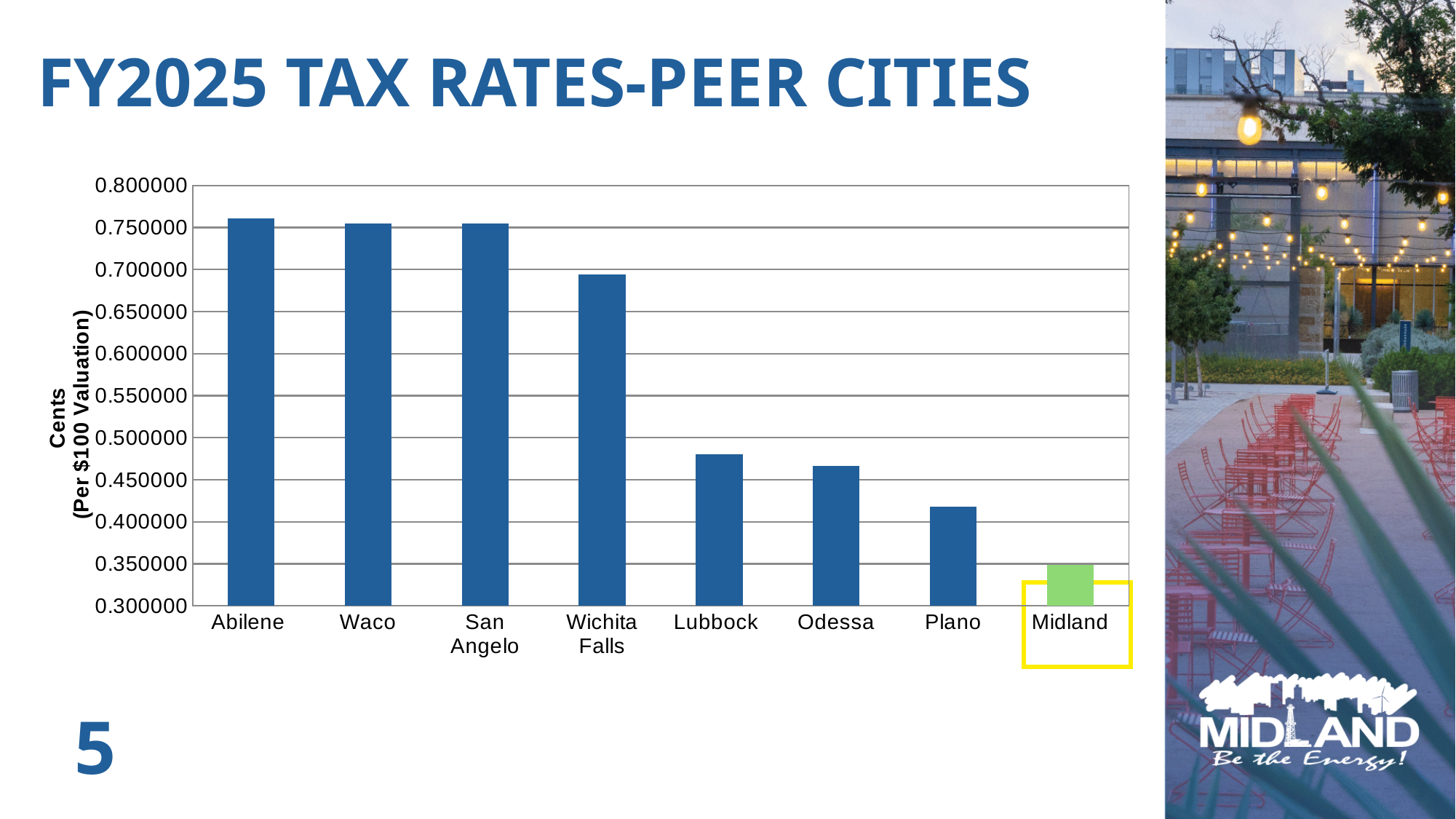
How many cities are shown on the x axis of the chart? 8 Is the value for Midland greater or less than 0.400000? less Which city has the lowest tax rate in the chart? Midland Do the tax rates generally rise or fall moving from left to right across the cities? fall Is the value for Odessa greater or less than 0.500000? less Which city has the highest tax rate in the chart? Abilene Is the value for Wichita Falls greater or less than 0.700000? less Which has the larger tax rate, Lubbock or Odessa? Lubbock What kind of chart is shown on the slide? bar chart What is the label on the vertical axis of the chart? Cents (Per $100 Valuation)